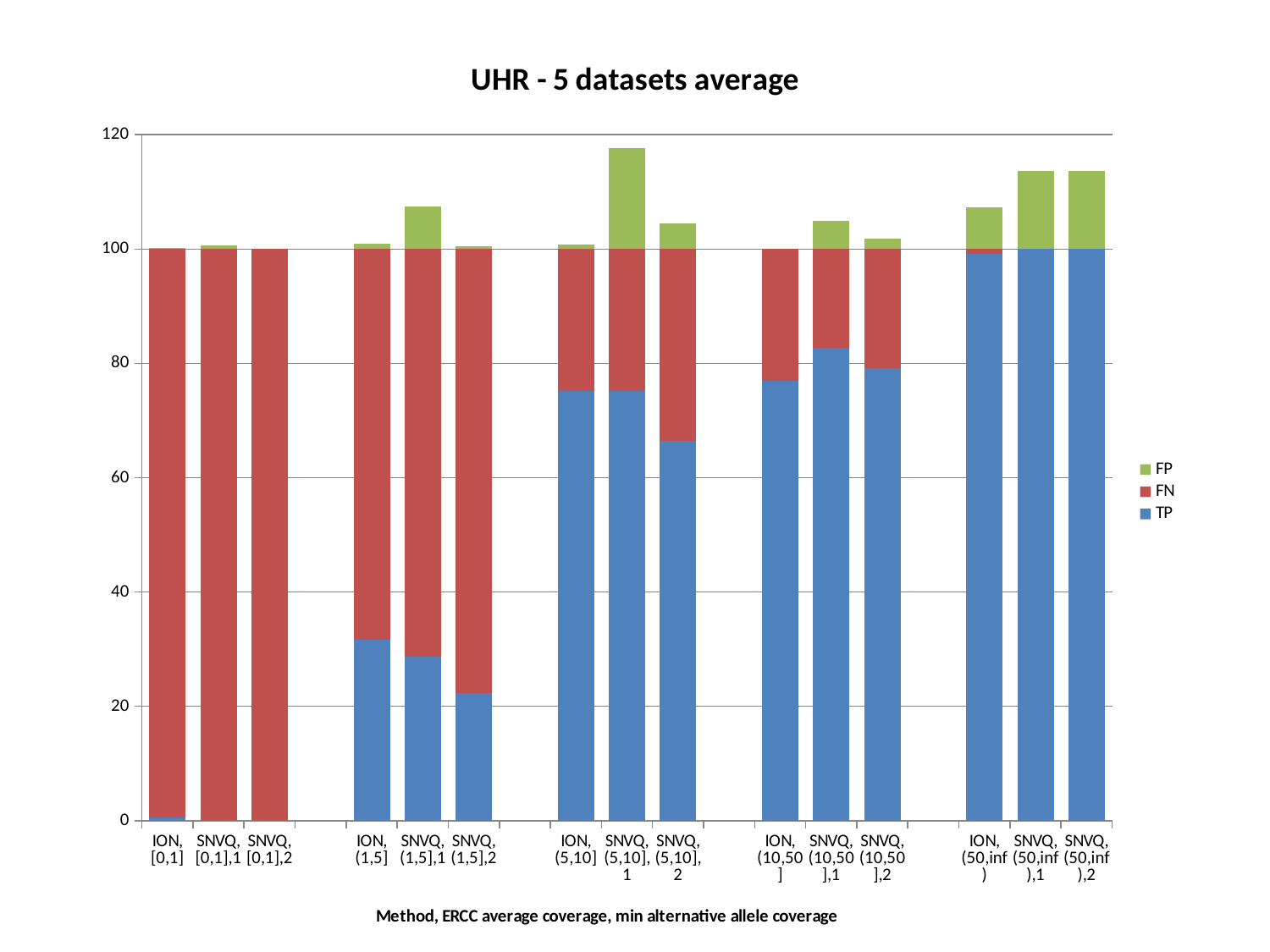
Is the TP value for SNVQ, (10,50],1 greater or less than 80? greater Is the TP value for SNVQ, (5,10],2 greater or less than 60? greater Which is larger, the TP value for SNVQ, (1,5],1 or the TP value for SNVQ, (1,5],2? SNVQ, (1,5],1 Do the TP values for the ION bars rise or fall as the ERCC average coverage bin increases from [0,1] to (50,inf)? rise Which series are listed in the legend? FP, FN, TP How many bars (categories) are plotted on the x axis? 15 What is the title of the chart? UHR - 5 datasets average Is the TP value for ION, (1,5] greater or less than 40? less How many series does the legend list? 3 Which category has the tallest stacked bar overall? SNVQ, (5,10],1 What kind of chart is shown on the slide? Stacked bar chart